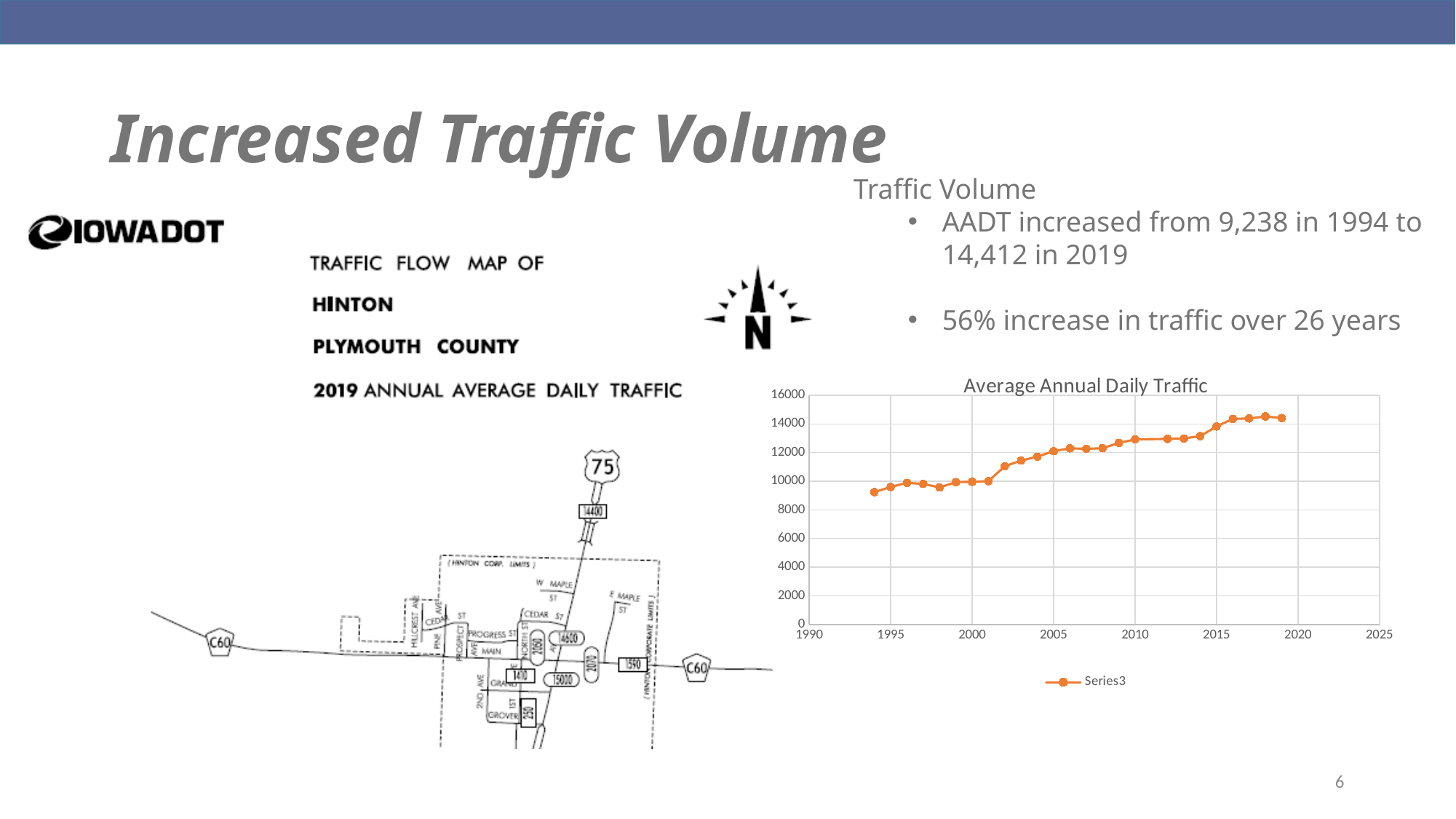
In the Average Annual Daily Traffic chart, is the value for 2010 greater or less than 14000? less According to the slide, what was the AADT in 2019? 14,412 What is the name of the series shown in the legend of the Average Annual Daily Traffic chart? Series3 Do the values in the Average Annual Daily Traffic chart generally rise or fall from 1994 to 2019? rise In the Average Annual Daily Traffic chart, which year has the lowest value? 1994 In the Average Annual Daily Traffic chart, is the value for 2010 greater or less than 12000? greater In the Average Annual Daily Traffic chart, is the value for 2019 greater or less than 14000? greater What kind of chart is shown under the title "Average Annual Daily Traffic"? line chart What is the title of the chart on the slide? Average Annual Daily Traffic In the Average Annual Daily Traffic chart, which is larger, the value for 2005 or the value for 2015? 2015 How many series does the legend of the Average Annual Daily Traffic chart list? 1